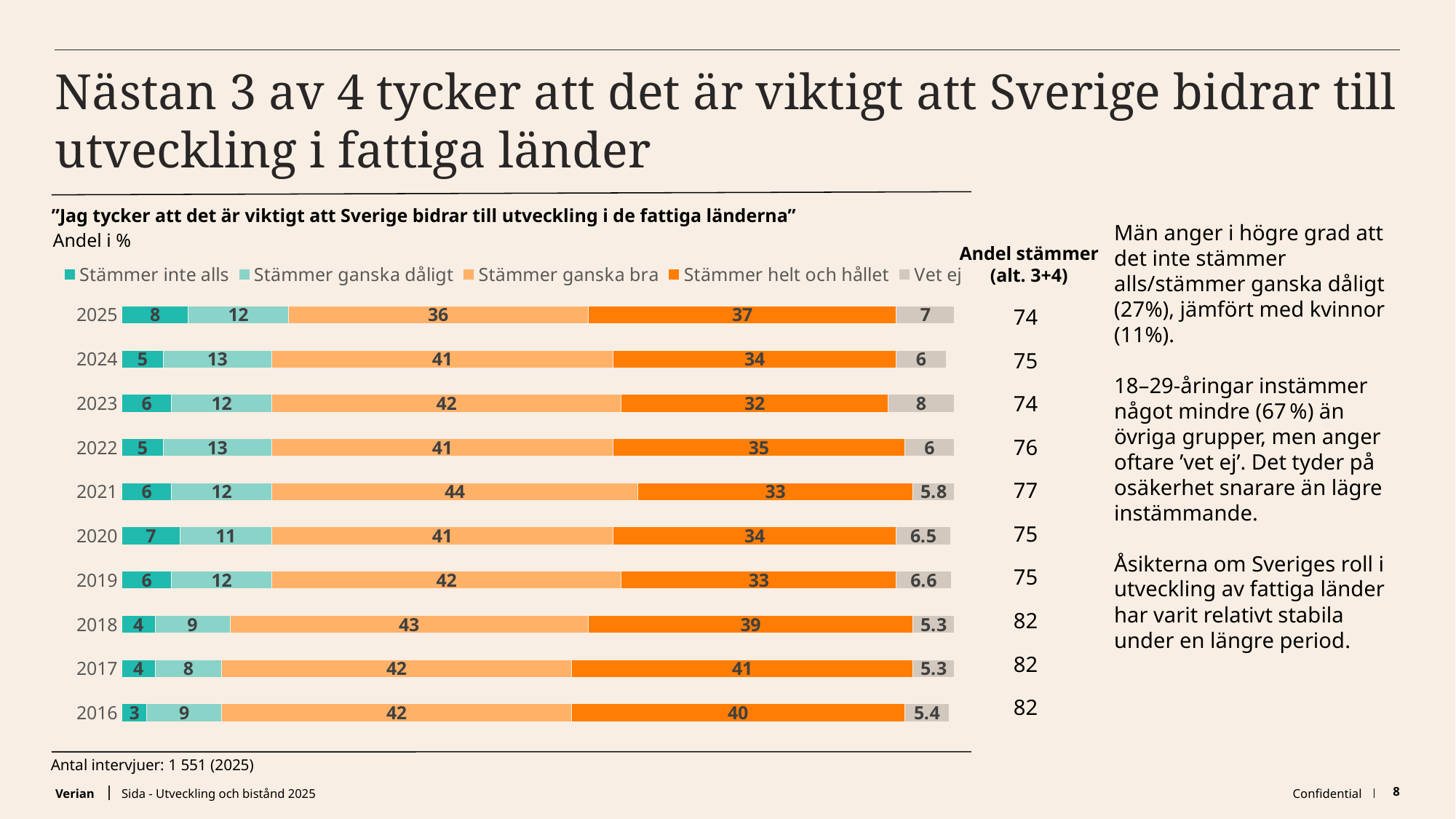
In which year is the "Stämmer inte alls" value lowest? 2016 Which is larger: the "Stämmer inte alls" value for 2025 or for 2020? 2025 What is the "Vet ej" value for 2019? 6.6 What is the value for "Stämmer ganska bra" in 2021? 44 How many years are shown in the chart? 10 What kind of chart is shown on the slide? Stacked bar chart What is the "Andel stämmer (alt. 3+4)" figure shown for 2022? 76 What is the value for "Stämmer helt och hållet" in 2025? 37 How many series does the legend list? 5 What is the total of the stacked bar for 2025? 100 In which year is the "Stämmer helt och hållet" value highest? 2017 What is the difference between the "Stämmer ganska bra" values for 2025 and 2024? 5